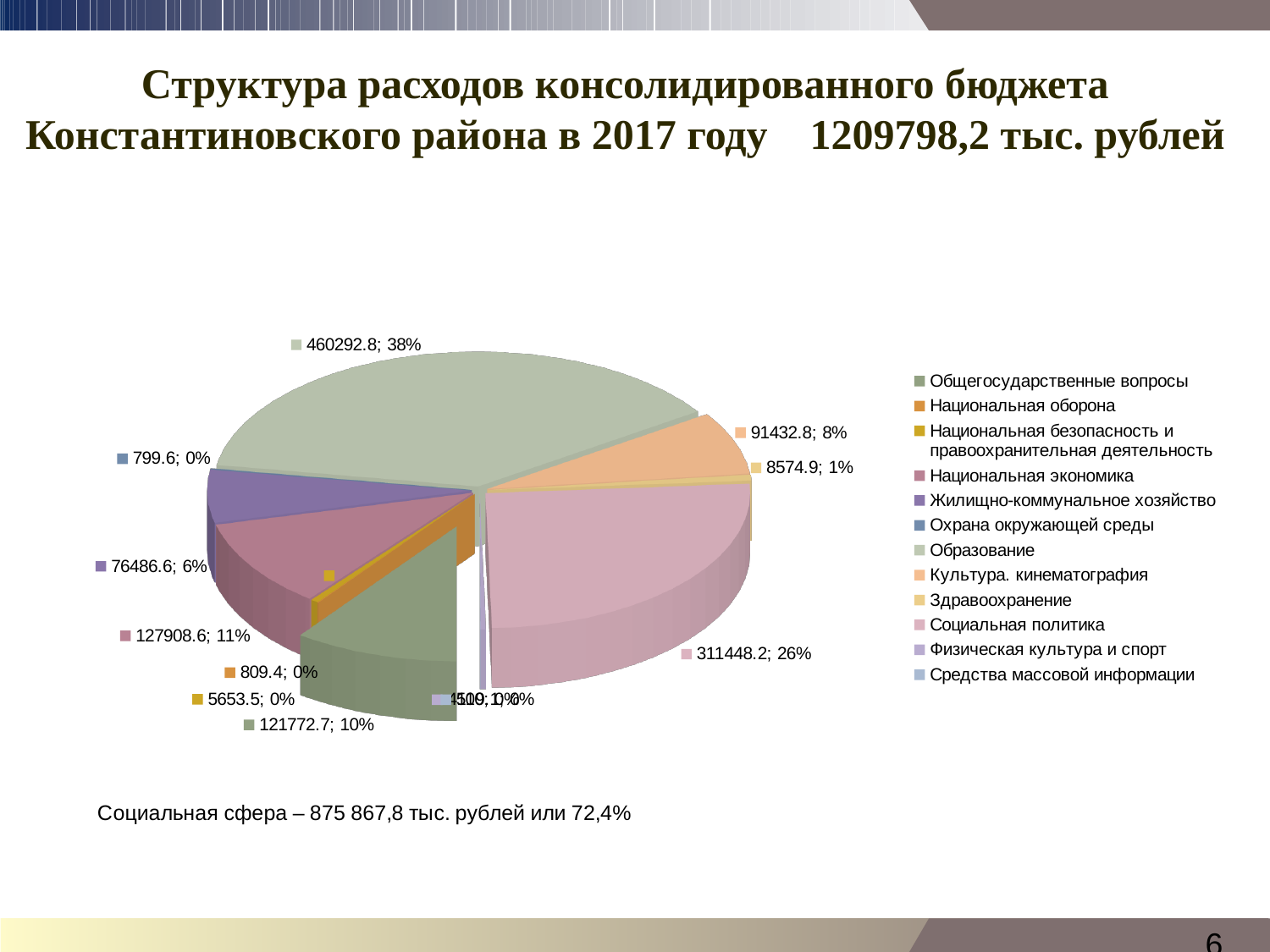
What is the difference between the values for Образование and Социальная политика? 148844.6 What total amount of expenditure is stated in the chart title? 1209798,2 тыс. рублей What is the value shown for Национальная экономика? 127908.6 Which category has the largest slice of the pie chart? Образование What share of the pie does Образование account for? 38% How many categories does the legend of the pie chart list? 12 What is the value shown for Жилищно-коммунальное хозяйство? 76486.6 What kind of chart is shown on the slide? pie chart What share of the pie does Социальная политика account for? 26% What is the value shown for Социальная политика? 311448.2 What is the value shown for Культура. кинематография? 91432.8 Which is larger, the value for Общегосударственные вопросы or the value for Национальная экономика? Национальная экономика